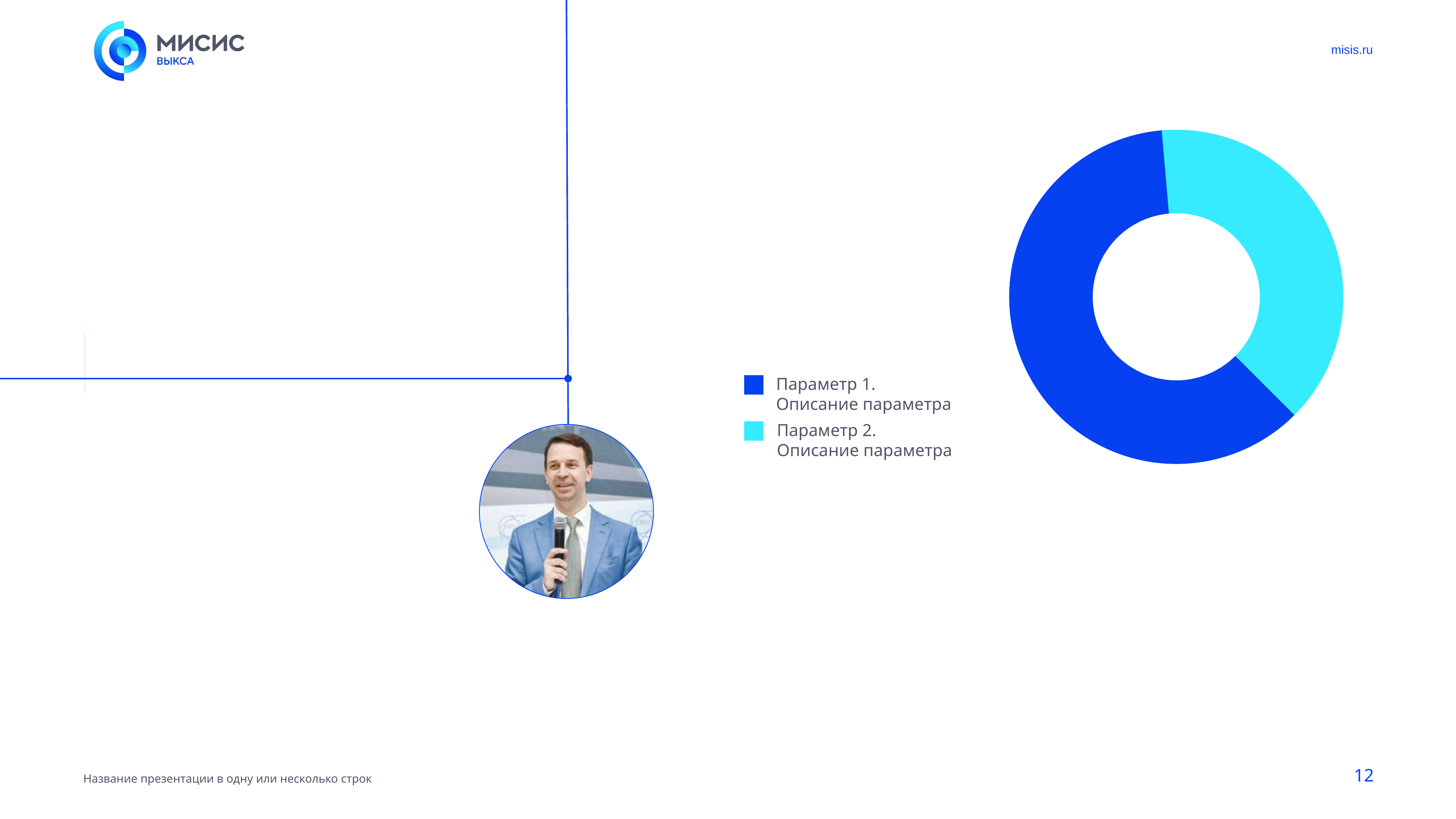
How many slices does the pie chart have? 2 What colour represents Параметр 1 in the pie chart? Dark blue What colour represents Параметр 2 in the pie chart? Light blue (cyan) Which category has the smallest slice in the pie chart? Параметр 2 What kind of chart is shown on the slide? Pie chart (donut) How many entries does the legend of the pie chart list? 2 Which slice is larger, Параметр 1 or Параметр 2? Параметр 1 Which category has the largest slice in the pie chart? Параметр 1